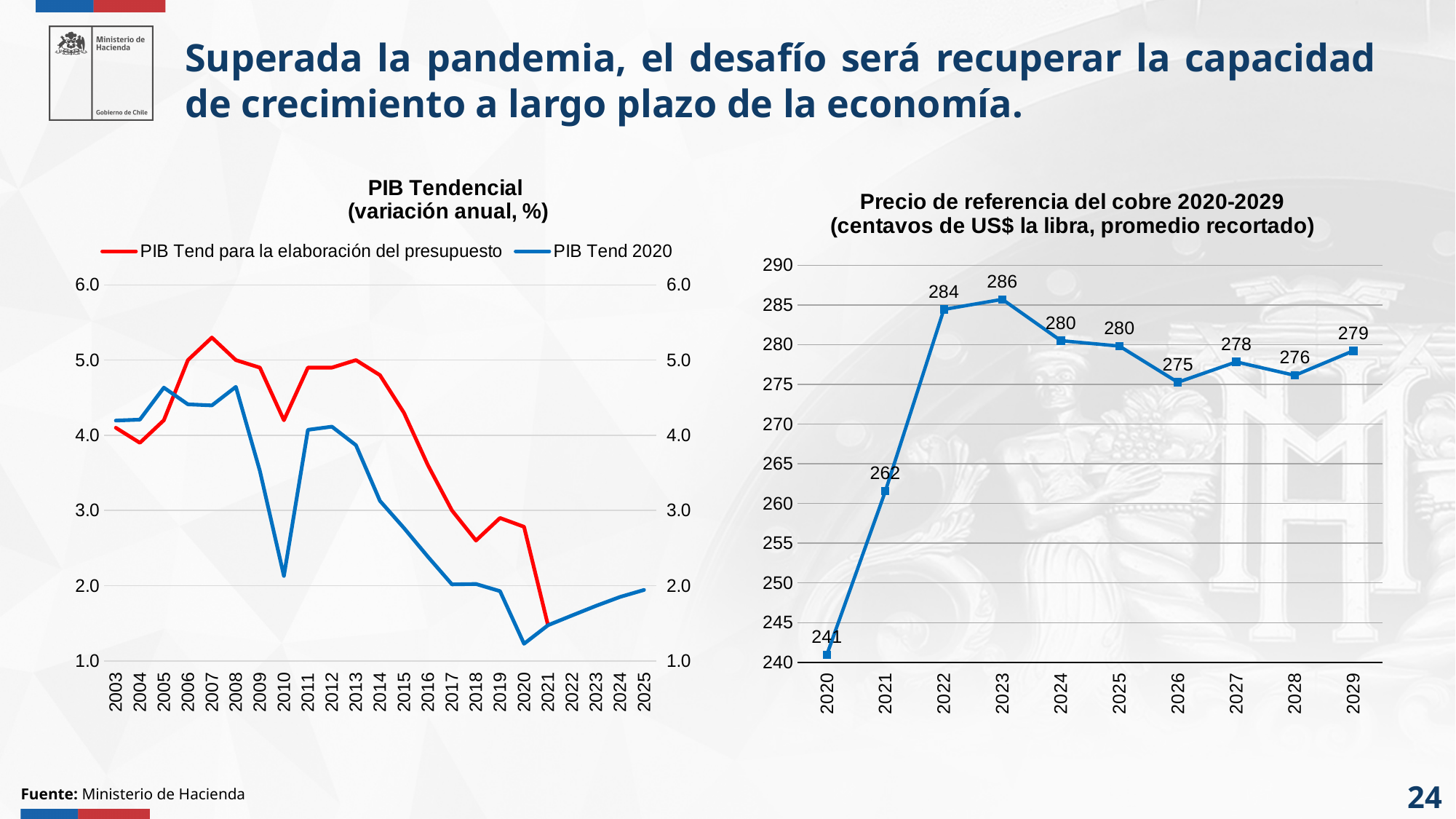
In the 'PIB Tendencial' chart, is the value of the 'PIB Tend 2020' series in 2010 greater or less than 3.0? less How many series does the legend of the 'PIB Tendencial' chart list? 2 In the 'Precio de referencia del cobre 2020-2029' chart, what is the value for 2020? 241 In the 'Precio de referencia del cobre 2020-2029' chart, what is the value for 2023? 286 In the 'Precio de referencia del cobre 2020-2029' chart, which year has the lowest value? 2020 In the 'PIB Tendencial' chart, is the value of the 'PIB Tend para la elaboración del presupuesto' series in 2007 greater or less than 5.0? greater In the 'Precio de referencia del cobre 2020-2029' chart, which year has the highest value? 2023 In the 'PIB Tendencial' chart, what colour is the line for 'PIB Tend 2020'? blue What kind of chart is the 'Precio de referencia del cobre 2020-2029' chart? line chart In the 'Precio de referencia del cobre 2020-2029' chart, which is larger, the value for 2027 or the value for 2028? 2027 How many data points are plotted in the 'Precio de referencia del cobre 2020-2029' chart? 10 In the 'Precio de referencia del cobre 2020-2029' chart, what is the difference between the values for 2022 and 2021? 22